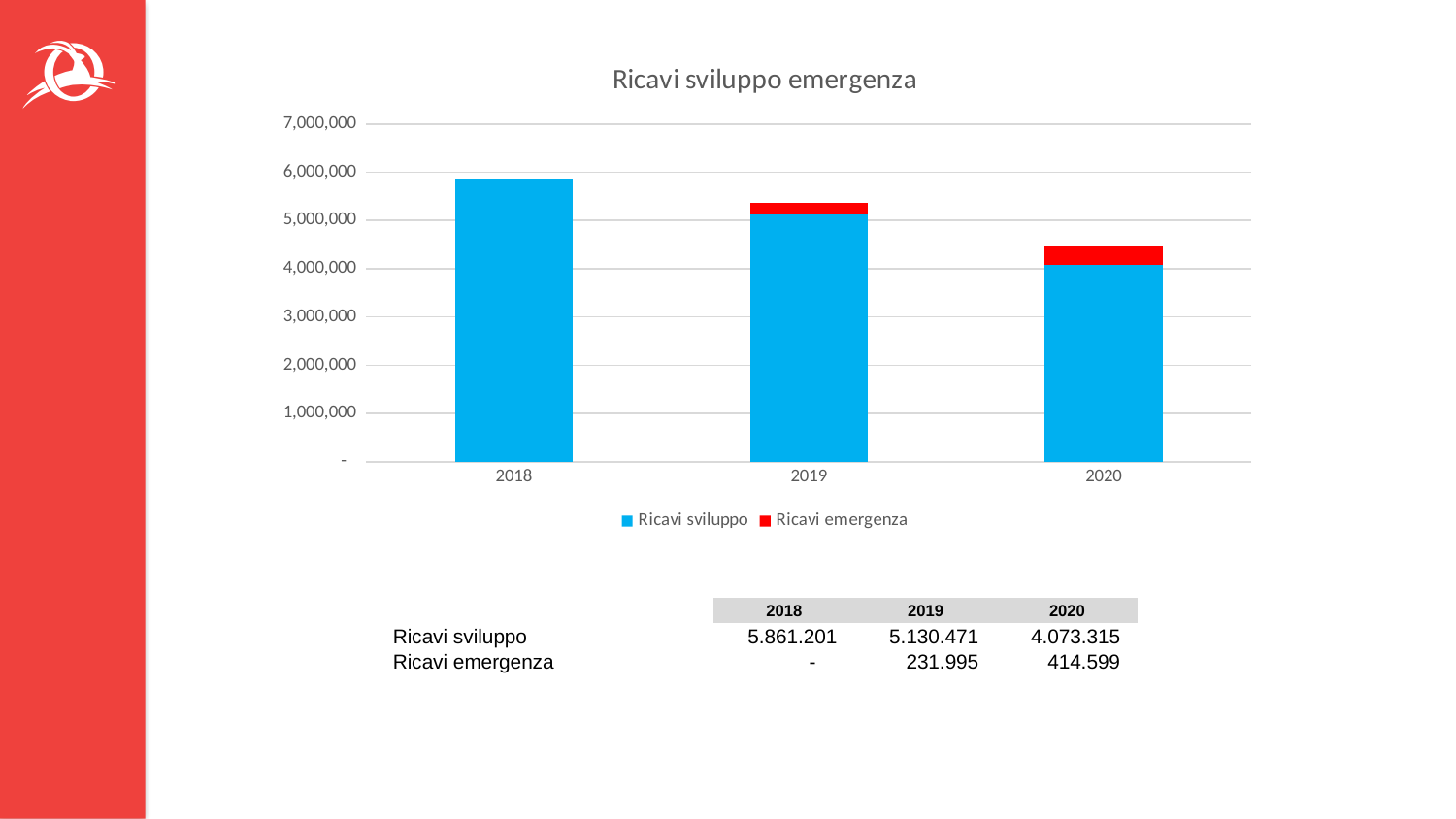
What type of chart is shown on the slide? stacked bar chart Which year has the lowest Ricavi sviluppo? 2020 What is the value of Ricavi emergenza for 2020? 414.599 Which year has the highest Ricavi sviluppo? 2018 What is the value of Ricavi emergenza for 2019? 231.995 What is the total of the stacked bar for 2020? 4.487.914 What is the value of Ricavi sviluppo for 2018? 5.861.201 Do the Ricavi sviluppo values rise or fall from 2018 to 2020? fall How many years are shown on the x axis? 3 What is the difference in Ricavi sviluppo between 2018 and 2019? 730.730 What is the chart's title? Ricavi sviluppo emergenza How many series does the legend list? 2